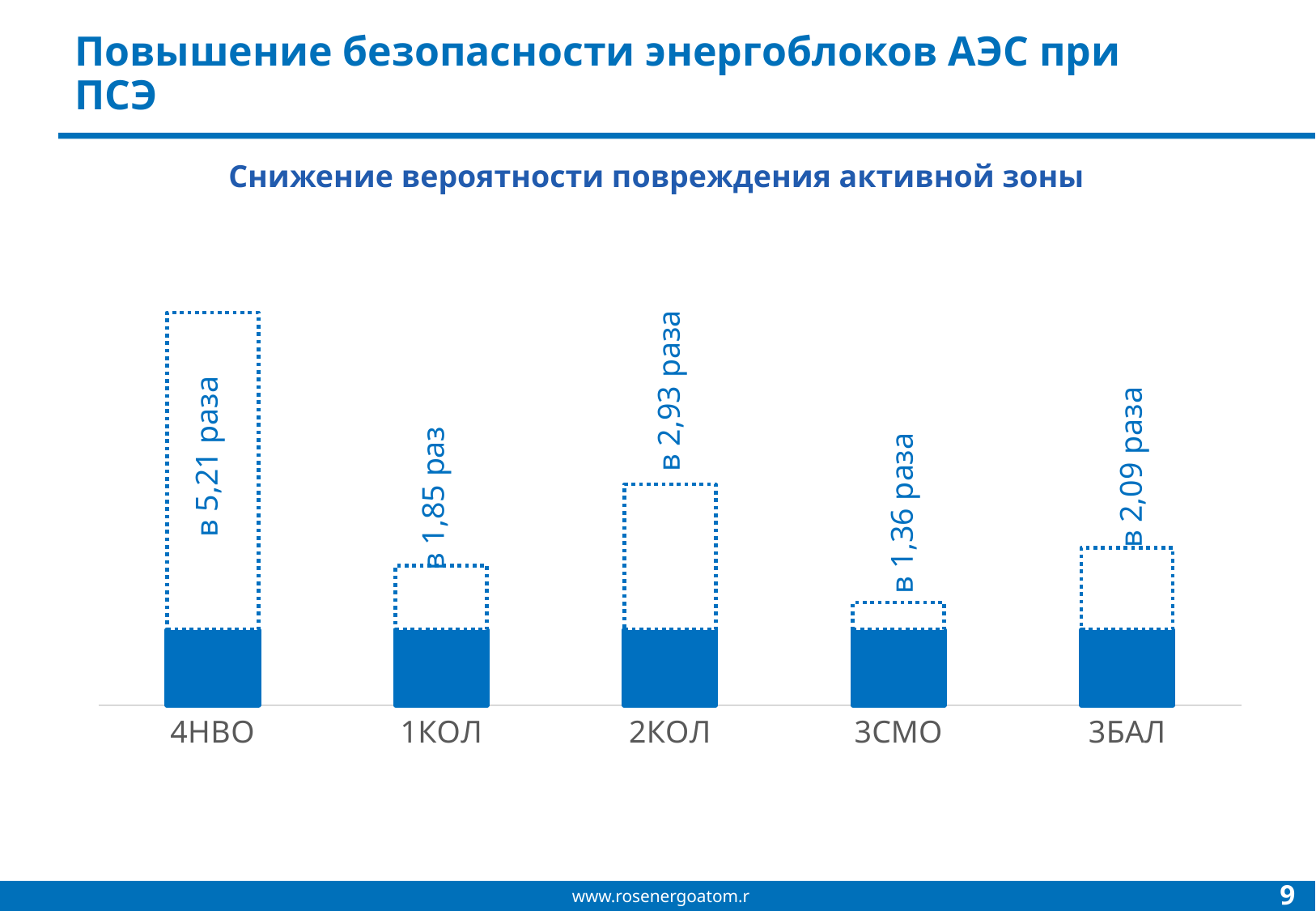
Which unit has the largest reduction factor? 4НВО What is the title of the chart? Снижение вероятности повреждения активной зоны How many units (categories) are shown on the chart? 5 What reduction factor is shown for 4НВО? в 5,21 раза What kind of chart is shown on the slide? Bar chart Which unit has the smallest reduction factor? 3СМО What reduction factor is shown for 1КОЛ? в 1,85 раз What reduction factor is shown for 2КОЛ? в 2,93 раза Which has a larger reduction factor, 2КОЛ or 3БАЛ? 2КОЛ What reduction factor is shown for 3СМО? в 1,36 раза What is the difference between the reduction factors for 4НВО and 1КОЛ? 3,36 What reduction factor is shown for 3БАЛ? в 2,09 раза